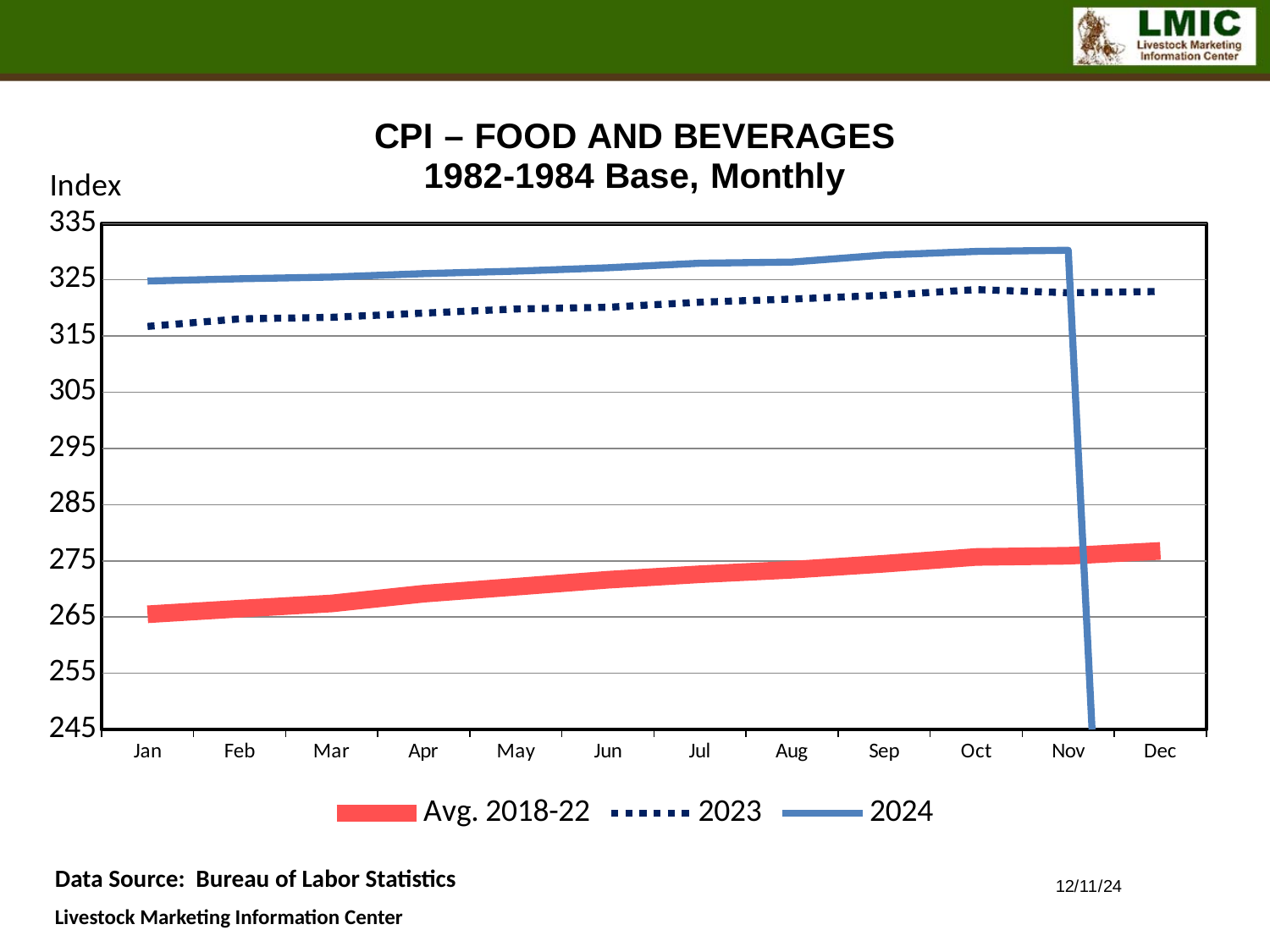
Does the Avg. 2018-22 series rise or fall from Jan to Dec? Rise In Jun, which is larger: the Avg. 2018-22 value or the 2023 value? 2023 Is the value for 2024 in Jan greater or less than 315? greater What is the title of the chart? CPI – FOOD AND BEVERAGES 1982-1984 Base, Monthly Is the value for 2023 in Jan greater or less than 325? less Is the value for Avg. 2018-22 in Jan greater or less than 275? less How many series does the legend list? 3 How many months are shown along the x axis? 12 What kind of chart is shown on the slide? Line chart In Jan, which is larger: the 2024 value or the 2023 value? 2024 Which series has the lowest values across the year? Avg. 2018-22